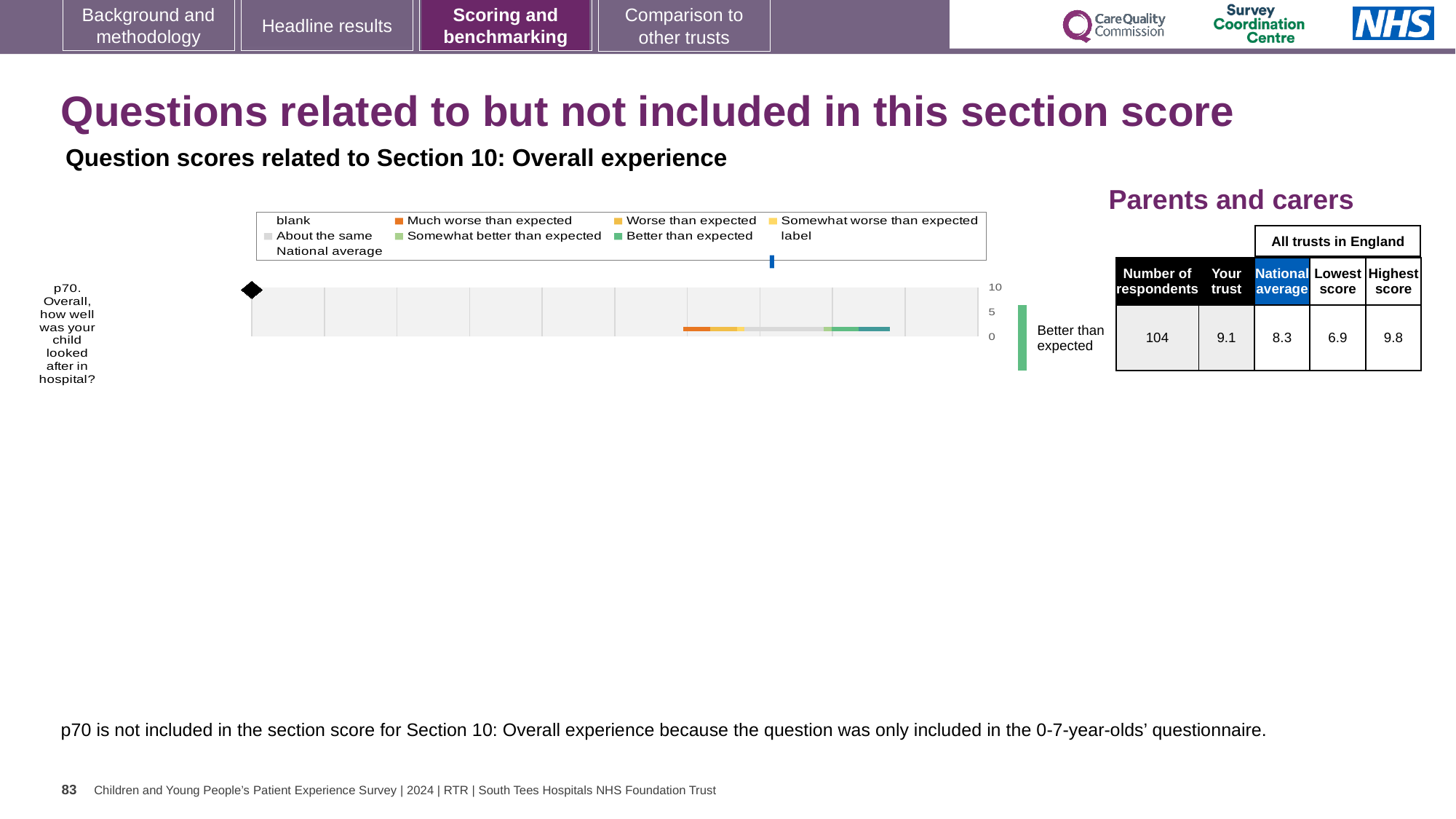
What kind of chart is used to show the p70 question score? bar chart Which question is plotted in the chart? p70. Overall, how well was your child looked after in hospital? How many questions are plotted in the chart? 1 For p70, what is the difference between the Highest score and the Lowest score among all trusts in England? 2.9 For p70, which is higher: Your trust score or the National average? Your trust For p70, what is the difference between Your trust score and the National average? 0.8 What rating label is shown to the right of the p70 bar? Better than expected In the Parents and carers table, what is the score for Your trust for p70? 9.1 In the Parents and carers table, what is the Number of respondents for p70? 104 In the Parents and carers table, what is the Lowest score among all trusts in England for p70? 6.9 In the Parents and carers table, what is the Highest score among all trusts in England for p70? 9.8 In the Parents and carers table, what is the National average for p70? 8.3